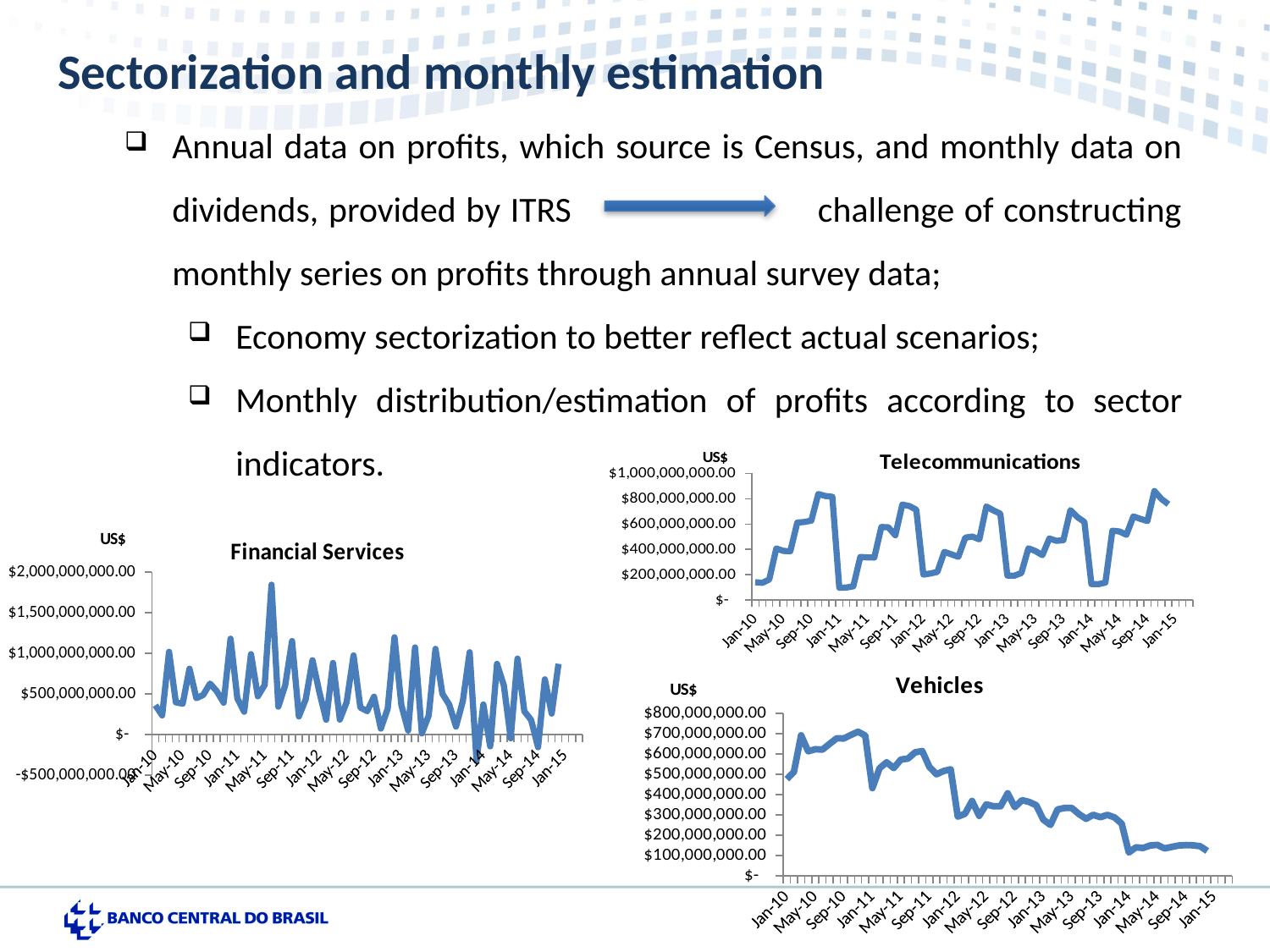
In the Vehicles chart, is the highest value on the line greater or less than $600,000,000.00? greater In the Vehicles chart, do the values generally rise or fall from Jan-10 to Jan-15? fall In the Financial Services chart, is the highest value on the line greater or less than $1,500,000,000.00? greater In the Telecommunications chart, is the highest value on the line greater or less than $800,000,000.00? greater What kind of chart is the Vehicles chart? line chart What unit label is shown above the vertical axis of the Telecommunications chart? US$ What kind of chart is the Financial Services chart? line chart How many charts are shown on the slide? 3